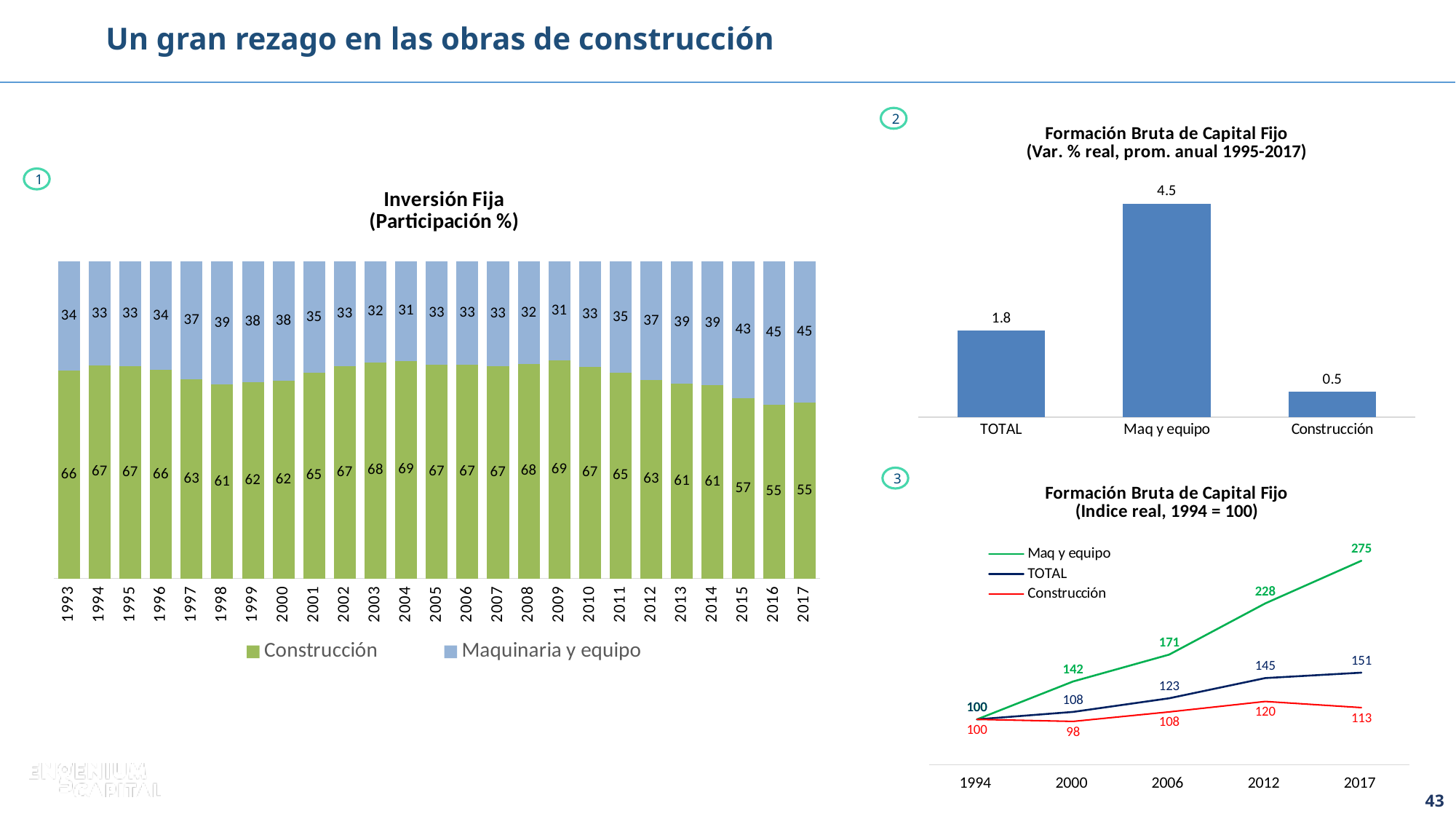
In the 'Inversión Fija (Participación %)' chart, how many years are shown on the x axis? 25 In the 'Inversión Fija (Participación %)' chart, how many series does the legend list? 2 In the 'Formación Bruta de Capital Fijo (Var. % real, prom. anual 1995-2017)' chart, which category has the highest value? Maq y equipo In the 'Formación Bruta de Capital Fijo (Indice real, 1994 = 100)' chart, does the Maq y equipo series rise or fall from 1994 to 2017? Rise In the 'Inversión Fija (Participación %)' chart, what is the value for Maquinaria y equipo in 1998? 39 In the 'Formación Bruta de Capital Fijo (Indice real, 1994 = 100)' chart, which is larger in 2017: TOTAL or Construcción? TOTAL In the 'Inversión Fija (Participación %)' chart, what is the difference between the Construcción values for 2004 and 2016? 14 In the 'Inversión Fija (Participación %)' chart, what is the value for Construcción in 2017? 55 In the 'Formación Bruta de Capital Fijo (Var. % real, prom. anual 1995-2017)' chart, what is the value for TOTAL? 1.8 What kind of chart is 'Formación Bruta de Capital Fijo (Indice real, 1994 = 100)'? Line chart In the 'Formación Bruta de Capital Fijo (Indice real, 1994 = 100)' chart, what is the value for Maq y equipo in 2012? 228 In the 'Formación Bruta de Capital Fijo (Var. % real, prom. anual 1995-2017)' chart, what is the difference between Maq y equipo and Construcción? 4.0